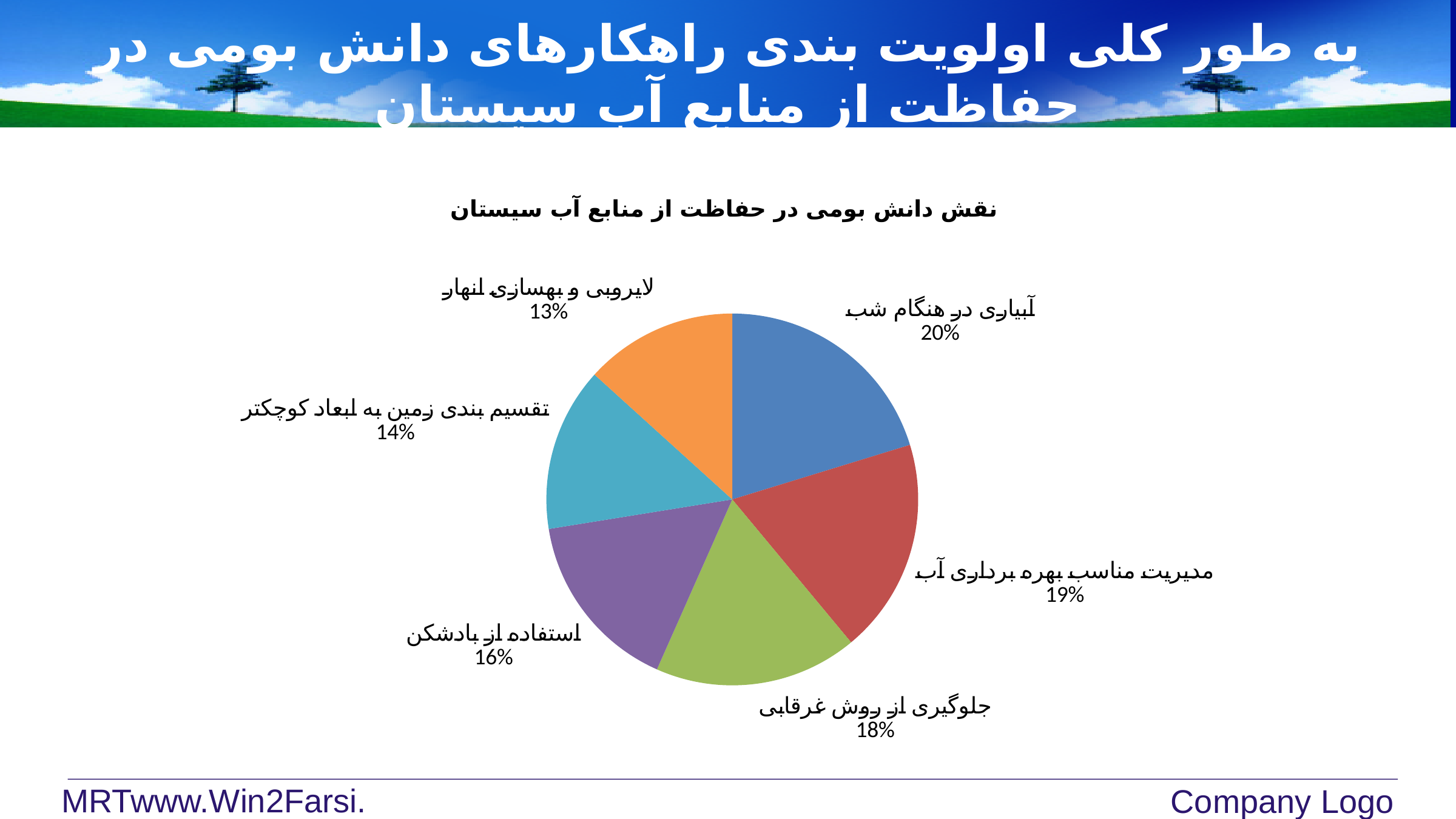
Which slice has the largest share of the pie? آبیاری در هنگام شب What kind of chart is shown on the slide? pie chart What share of the pie is labelled "استفاده از بادشکن"? 16% Which slice is larger: "استفاده از بادشکن" or "تقسیم بندی زمین به ابعاد کوچکتر"? استفاده از بادشکن What share of the pie is labelled "جلوگیری از روش غرقابی"? 18% What share of the pie is labelled "آبیاری در هنگام شب"? 20% What is the difference in percentage points between "آبیاری در هنگام شب" and "لایروبی و بهسازی انهار"? 7 How many slices does the pie chart have? 6 Which slice has the smallest share of the pie? لایروبی و بهسازی انهار What is the title of the chart? نقش دانش بومی در حفاظت از منابع آب سیستان